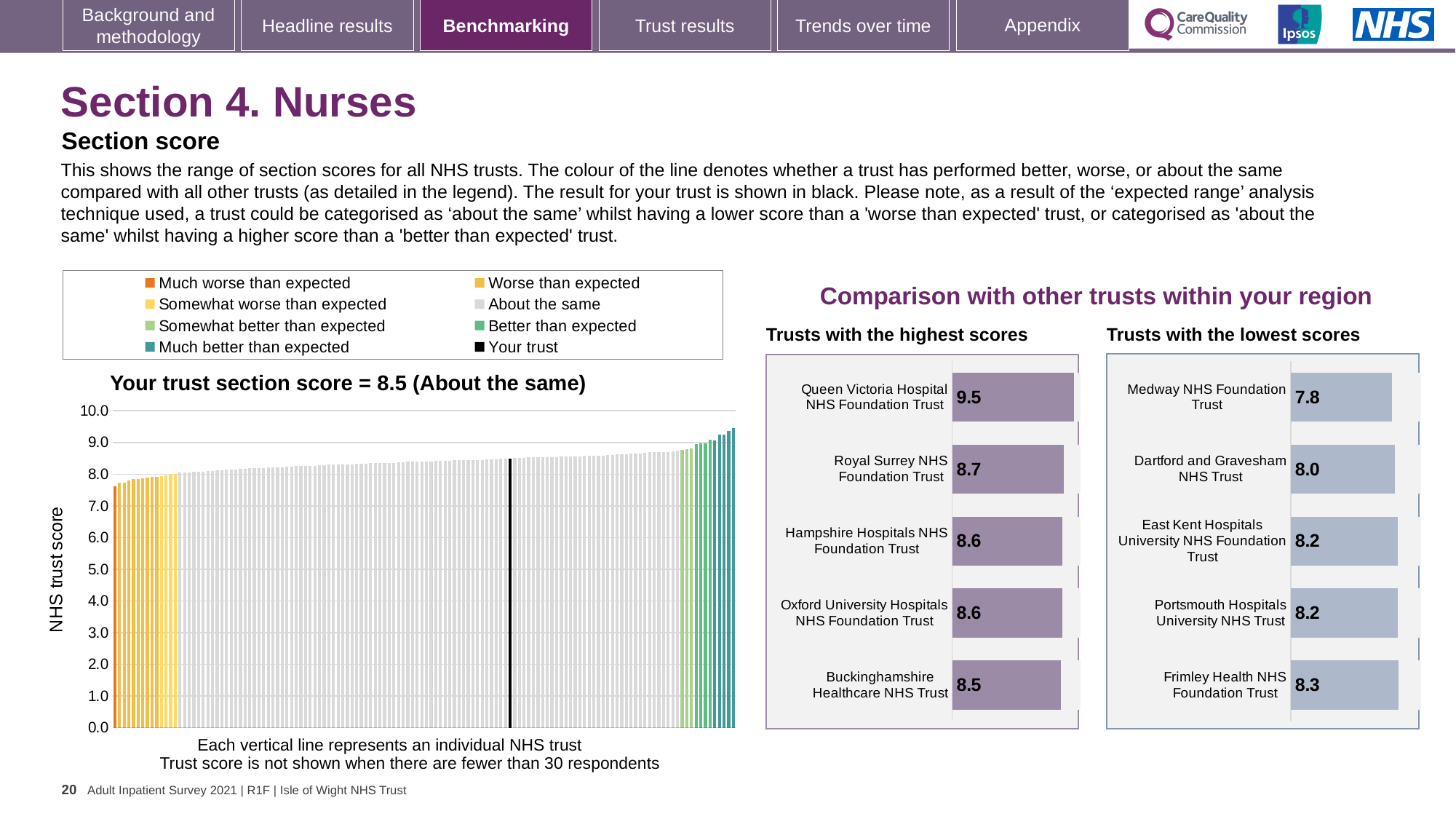
According to the main chart's title on the left, what is your trust's section score? 8.5 In the 'Trusts with the highest scores' chart, what is the difference between the scores of Queen Victoria Hospital NHS Foundation Trust and Buckinghamshire Healthcare NHS Trust? 1.0 In the 'Trusts with the lowest scores' chart, which trust has the lowest score? Medway NHS Foundation Trust In the 'Trusts with the lowest scores' chart, what is the difference between the scores of Frimley Health NHS Foundation Trust and Medway NHS Foundation Trust? 0.5 In the 'Trusts with the lowest scores' chart, which has the larger score: Dartford and Gravesham NHS Trust or Frimley Health NHS Foundation Trust? Frimley Health NHS Foundation Trust In the 'Trusts with the highest scores' chart, what is the score for Queen Victoria Hospital NHS Foundation Trust? 9.5 In the 'Trusts with the lowest scores' chart, what is the score for Medway NHS Foundation Trust? 7.8 How many entries does the legend above the main chart on the left list? 8 How many trusts are shown in the 'Trusts with the highest scores' chart? 5 In the main chart on the left, do the trust scores rise or fall from left to right along the x axis? rise In the 'Trusts with the highest scores' chart, which trust has the highest score? Queen Victoria Hospital NHS Foundation Trust What kind of chart is the main chart on the left showing the range of section scores for all NHS trusts? bar chart